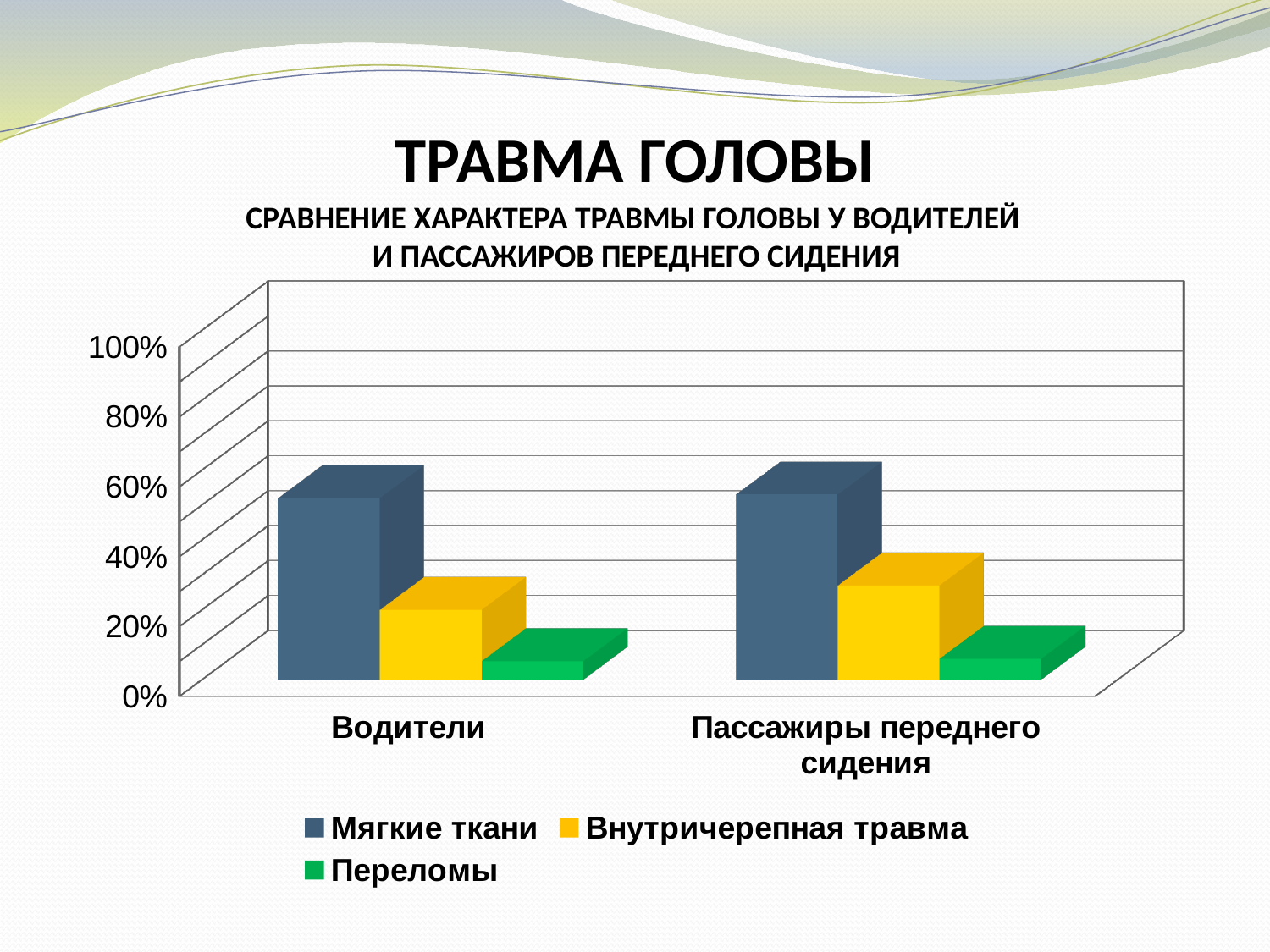
Is the value of Внутричерепная травма for Пассажиры переднего сидения greater or less than 60%? less How many categories are shown on the x axis of the chart? 2 Is the value of Переломы for Водители greater or less than 20%? less Which series is shown in green in the chart legend? Переломы What kind of chart is shown on the slide? bar chart Is the value of Мягкие ткани for Пассажиры переднего сидения greater or less than 80%? less Which category has the larger value for Внутричерепная травма: Водители or Пассажиры переднего сидения? Пассажиры переднего сидения Which series has the lowest value for Пассажиры переднего сидения? Переломы Which series has the highest value for Водители? Мягкие ткани For Водители, which is larger: Мягкие ткани or Переломы? Мягкие ткани How many series does the chart legend list? 3